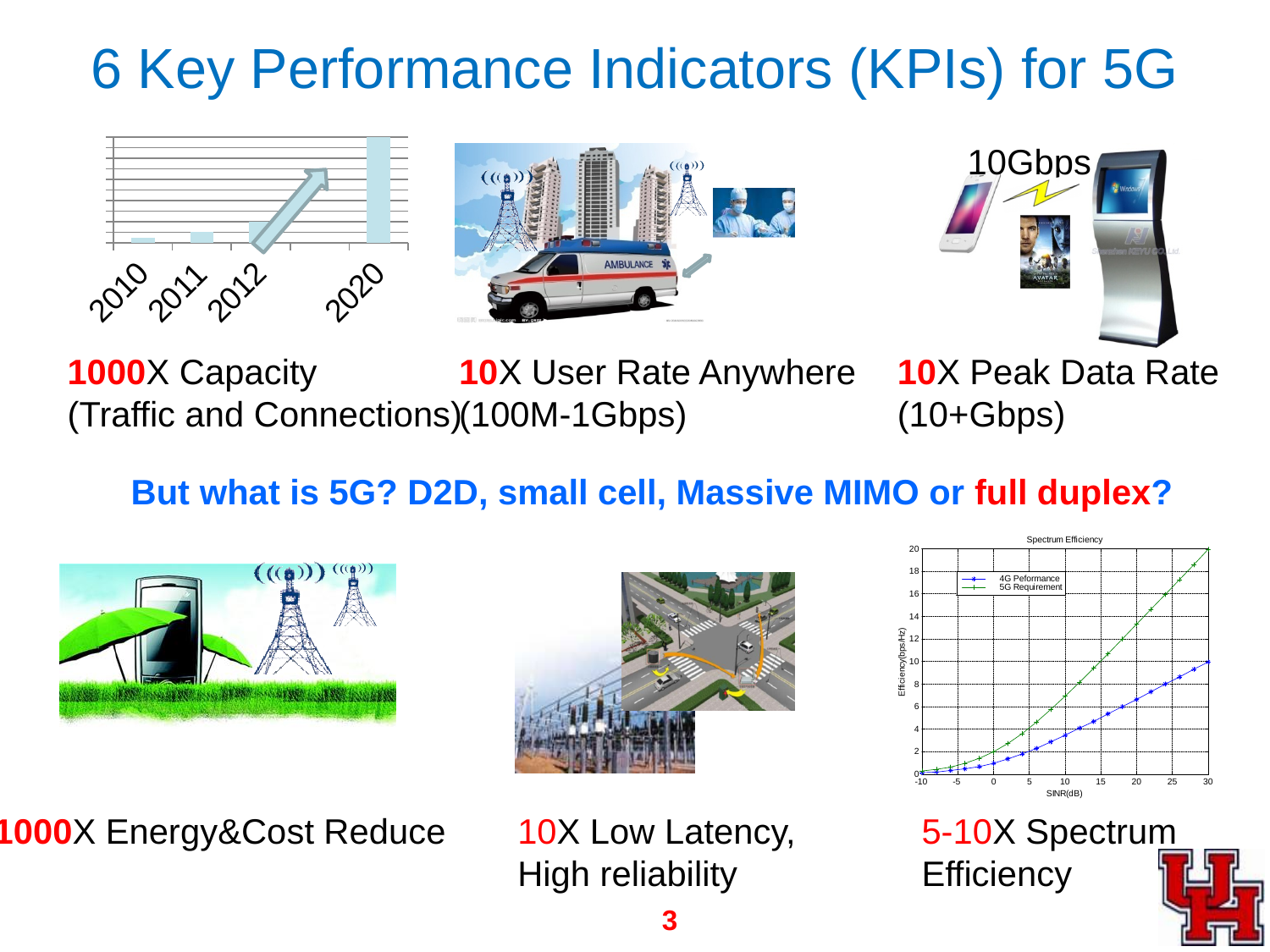
In the top-left bar chart, which year has the tallest bar? 2020 In the top-left bar chart, do the bars rise or fall from 2010 to 2020? rise In the Spectrum Efficiency chart, which series is higher at SINR 30 dB, 4G Performance or 5G Requirement? 5G Requirement In the Spectrum Efficiency chart, is the 5G Requirement value at SINR 30 dB greater or less than 18? greater How many series does the legend of the Spectrum Efficiency chart list? 2 In the Spectrum Efficiency chart, is the 4G Performance value at SINR 30 dB greater or less than 12? less What is the title of the chart at the bottom right of the slide? Spectrum Efficiency What kind of chart is the chart at the top left of the slide (with years 2010 to 2020)? bar chart In the top-left bar chart, how many year categories are shown on the x axis? 4 In the top-left bar chart, which bar is taller, 2011 or 2012? 2012 What kind of chart is the Spectrum Efficiency chart? line chart In the top-left bar chart, which year has the shortest bar? 2010